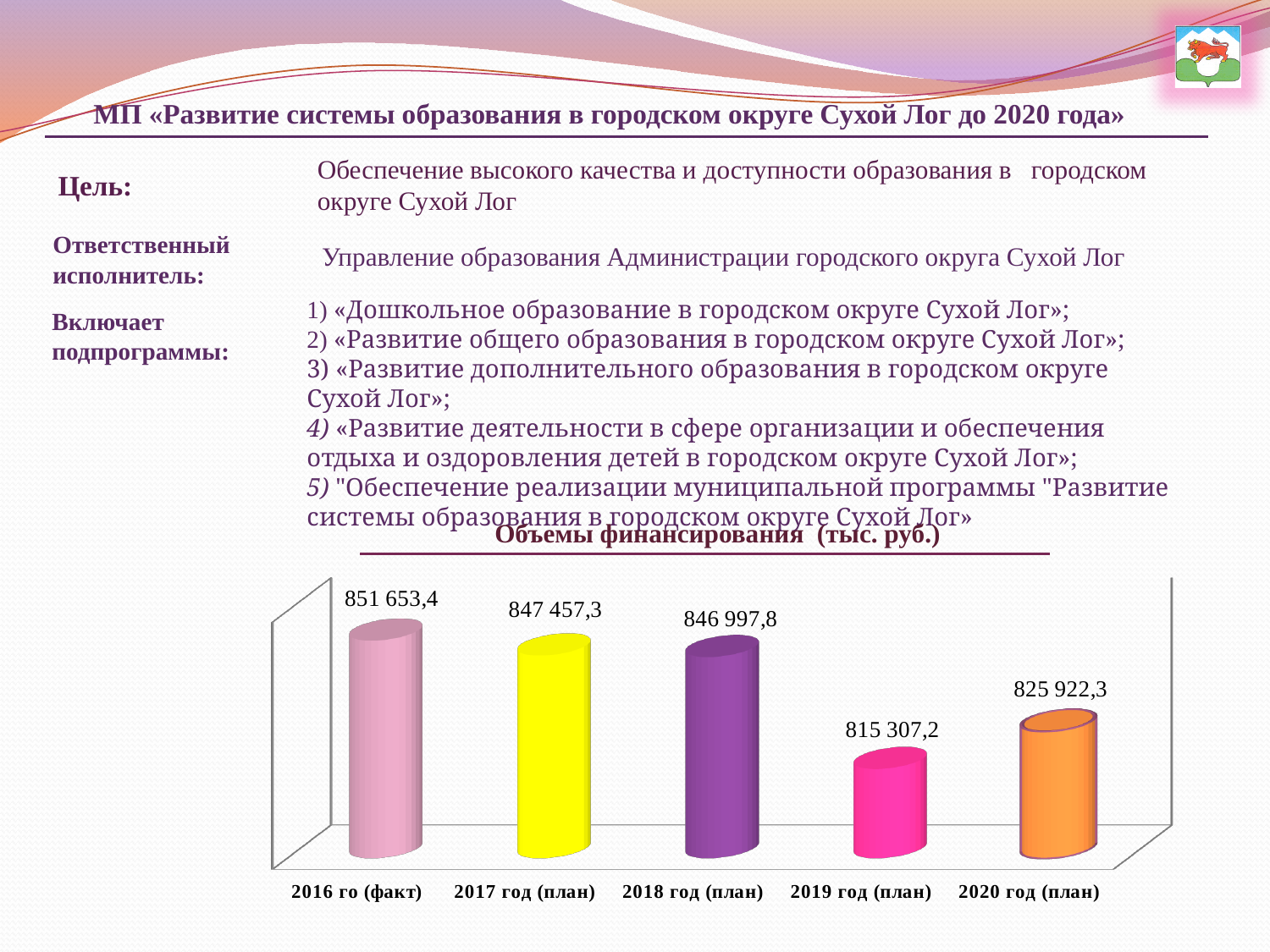
Do the values rise or fall from 2016 to 2019? fall What type of chart is shown on the slide? bar chart What is the value for 2019 год (план)? 815 307,2 What is the value for 2016 го (факт)? 851 653,4 How many categories (years) are shown on the chart? 5 What is the difference between the values for 2016 го (факт) and 2017 год (план)? 4 196,1 Which year has the lowest funding volume? 2019 год (план) What is the value for 2020 год (план)? 825 922,3 What is the title of the chart? Объемы финансирования (тыс. руб.) What is the value for 2018 год (план)? 846 997,8 Which is larger, the value for 2017 год (план) or 2018 год (план)? 2017 год (план) Which year has the highest funding volume? 2016 го (факт)